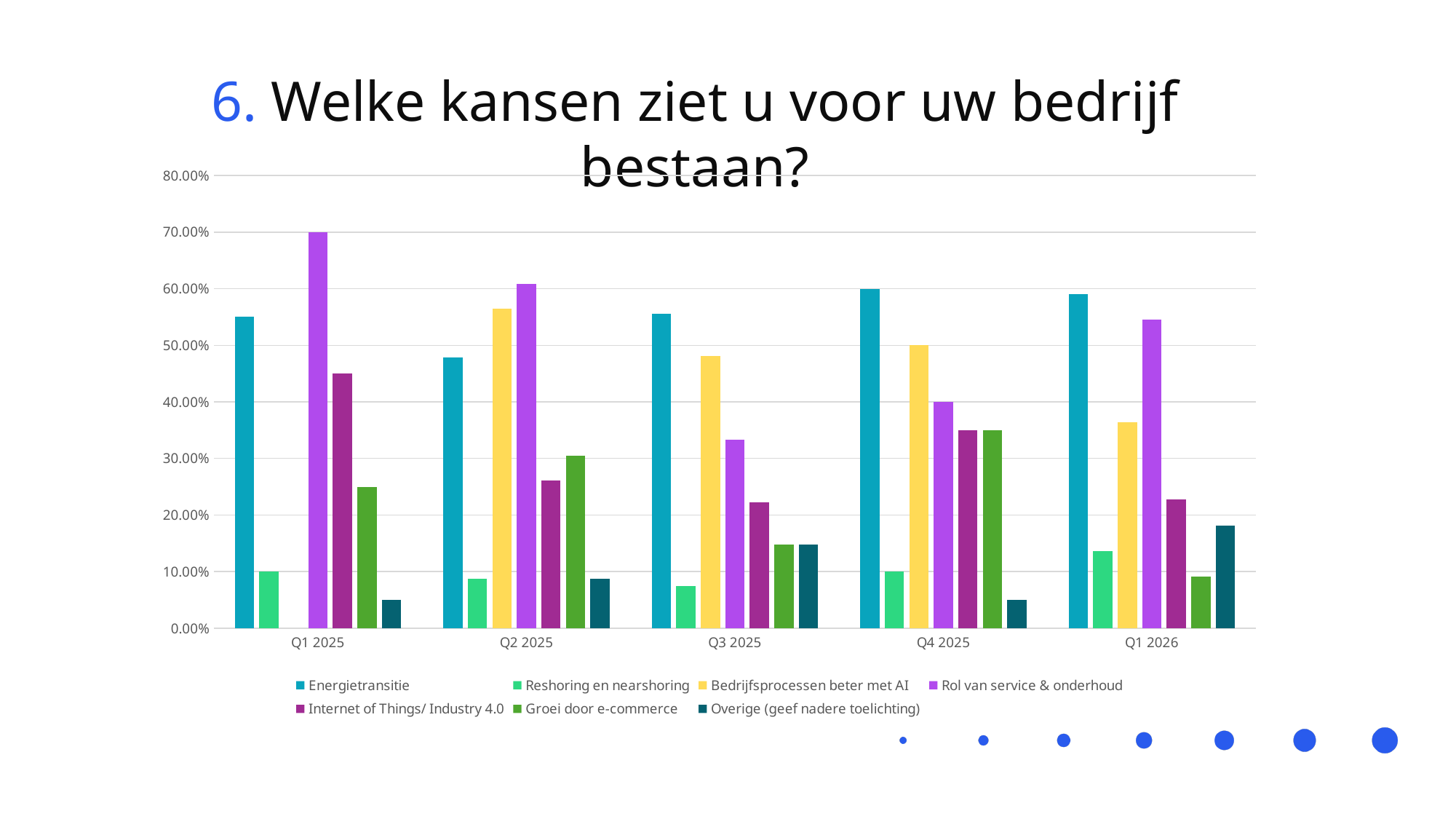
How many quarters are shown on the x axis? 5 Is the value for Energietransitie in Q4 2025 greater or less than 50.00%? greater How many series does the legend list? 7 What kind of chart is shown on the slide? bar chart In Q2 2025, which is larger: Bedrijfsprocessen beter met AI or Energietransitie? Bedrijfsprocessen beter met AI In which quarter is the value for Rol van service & onderhoud the highest? Q1 2025 Which series has the highest value in Q3 2025? Energietransitie Is the value for Rol van service & onderhoud in Q3 2025 greater or less than 40.00%? less In Q1 2026, which is larger: Rol van service & onderhoud or Bedrijfsprocessen beter met AI? Rol van service & onderhoud Is the value for Internet of Things/ Industry 4.0 in Q1 2025 greater or less than 40.00%? greater Which series has the lowest value in Q1 2025? Overige (geef nadere toelichting) What is the title of the chart on the slide? 6. Welke kansen ziet u voor uw bedrijf bestaan?